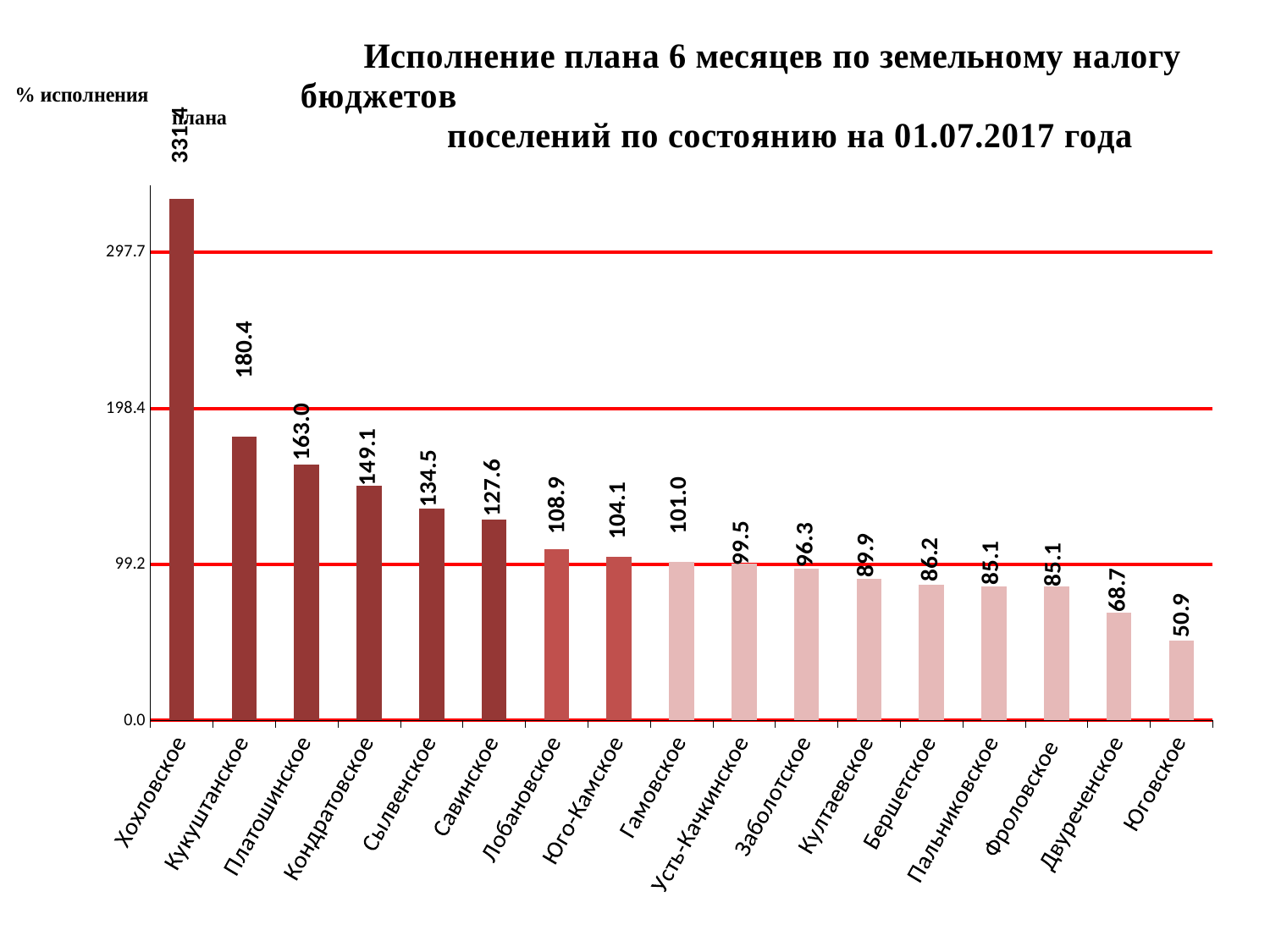
What is the value for Сылвенское? 134.5 Which settlement has the highest value? Хохловское What type of chart is shown on the slide? bar chart Which is larger, the value for Лобановское or the value for Гамовское? Лобановское How many settlements are shown on the x axis? 17 Do the values rise or fall from left to right along the x axis? fall What is the value for Кукуштанское? 180.4 What is the value for Заболотское? 96.3 Which settlement has the lowest value? Юговское What is the difference between the values for Двуреченское and Юговское? 17.8 What is the difference between the values for Платошинское and Кондратовское? 13.9 What is the value for Юговское? 50.9